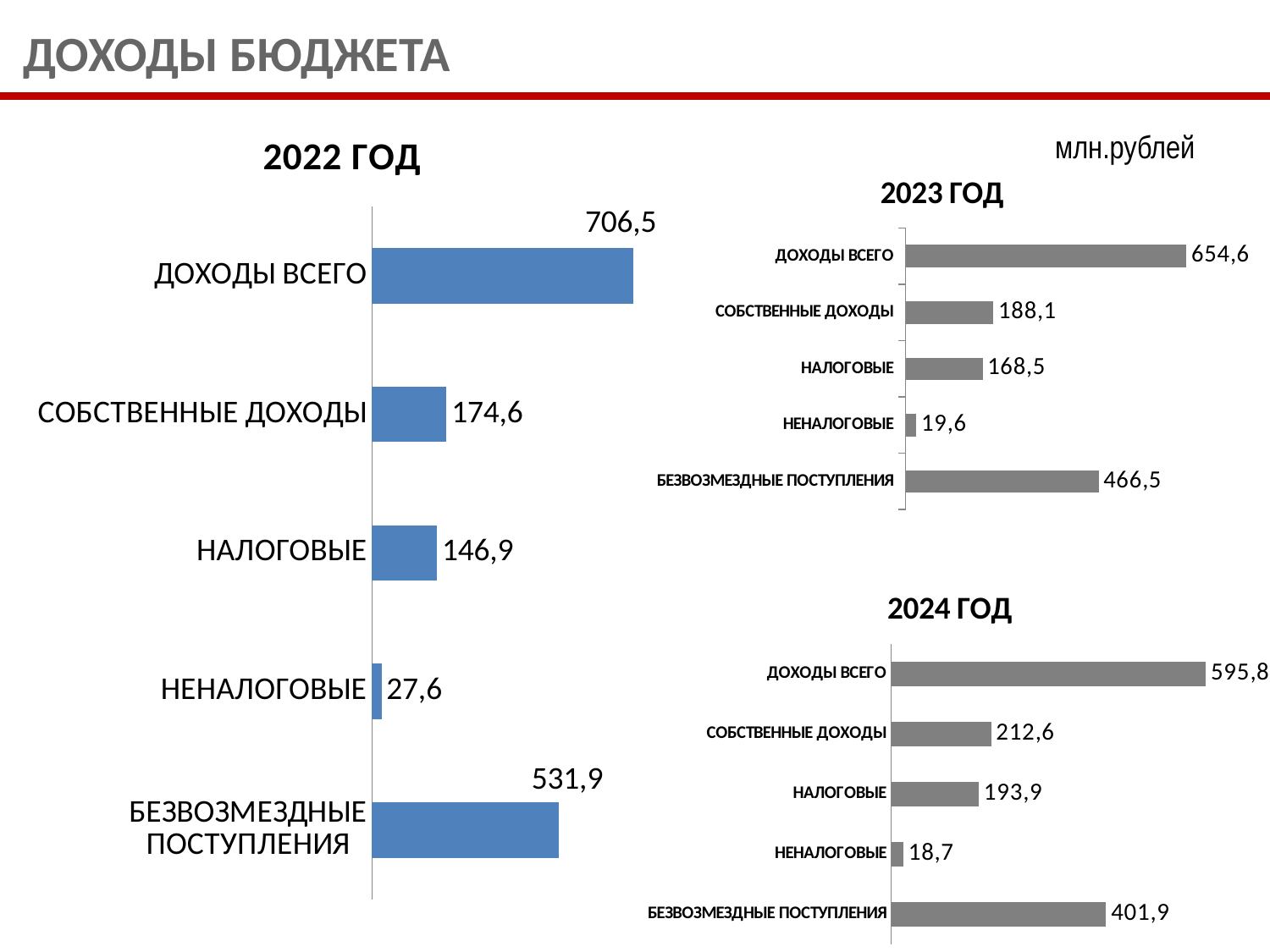
What unit is indicated for the values on the slide? млн.рублей How many charts are on the slide? 3 In the 2024 ГОД chart, which category has the highest value? ДОХОДЫ ВСЕГО In the 2022 ГОД chart, what is the value for ДОХОДЫ ВСЕГО? 706,5 In the 2023 ГОД chart, what is the difference between СОБСТВЕННЫЕ ДОХОДЫ and НАЛОГОВЫЕ? 19,6 In the 2024 ГОД chart, what is the difference between ДОХОДЫ ВСЕГО and БЕЗВОЗМЕЗДНЫЕ ПОСТУПЛЕНИЯ? 193,9 Which is larger: НЕНАЛОГОВЫЕ in the 2022 ГОД chart or НЕНАЛОГОВЫЕ in the 2024 ГОД chart? 2022 ГОД In the 2024 ГОД chart, what is the value for БЕЗВОЗМЕЗДНЫЕ ПОСТУПЛЕНИЯ? 401,9 In the 2023 ГОД chart, what is the value for НАЛОГОВЫЕ? 168,5 What type of chart is the 2022 ГОД chart? Bar chart How many categories are shown in the 2023 ГОД chart? 5 In the 2022 ГОД chart, which category has the lowest value? НЕНАЛОГОВЫЕ